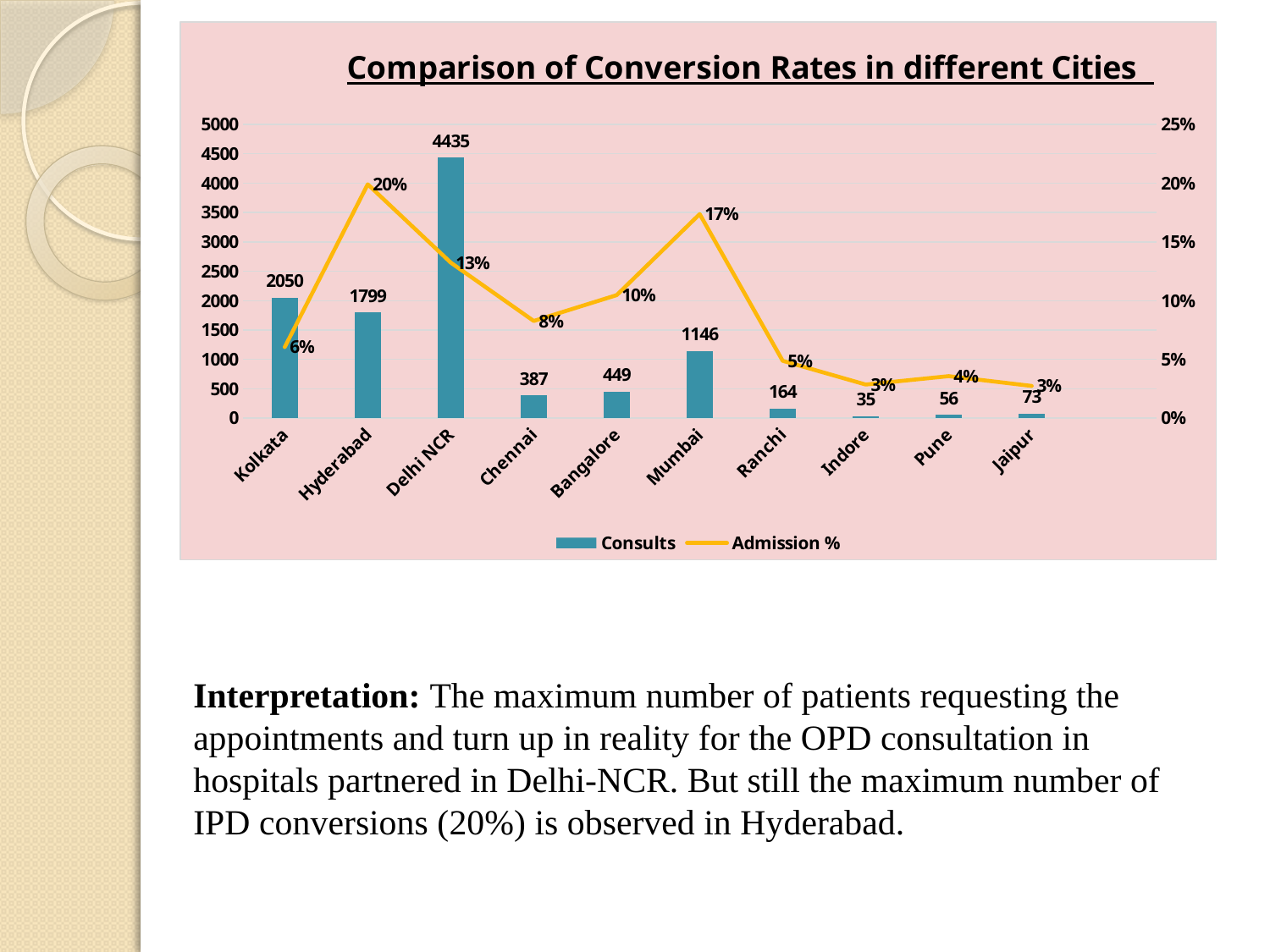
What is the difference in Consults between Kolkata and Hyderabad? 251 How many cities are shown on the x axis? 10 How many series does the legend list? 2 What is the Admission % for Hyderabad? 20% What is the Admission % for Chennai? 8% Which has more Consults, Chennai or Bangalore? Bangalore What is the number of Consults for Delhi NCR? 4435 What is the number of Consults for Mumbai? 1146 Which city has the highest Admission %? Hyderabad Which city has the highest number of Consults? Delhi NCR Which city has the lowest number of Consults? Indore What is the title of the chart? Comparison of Conversion Rates in different Cities